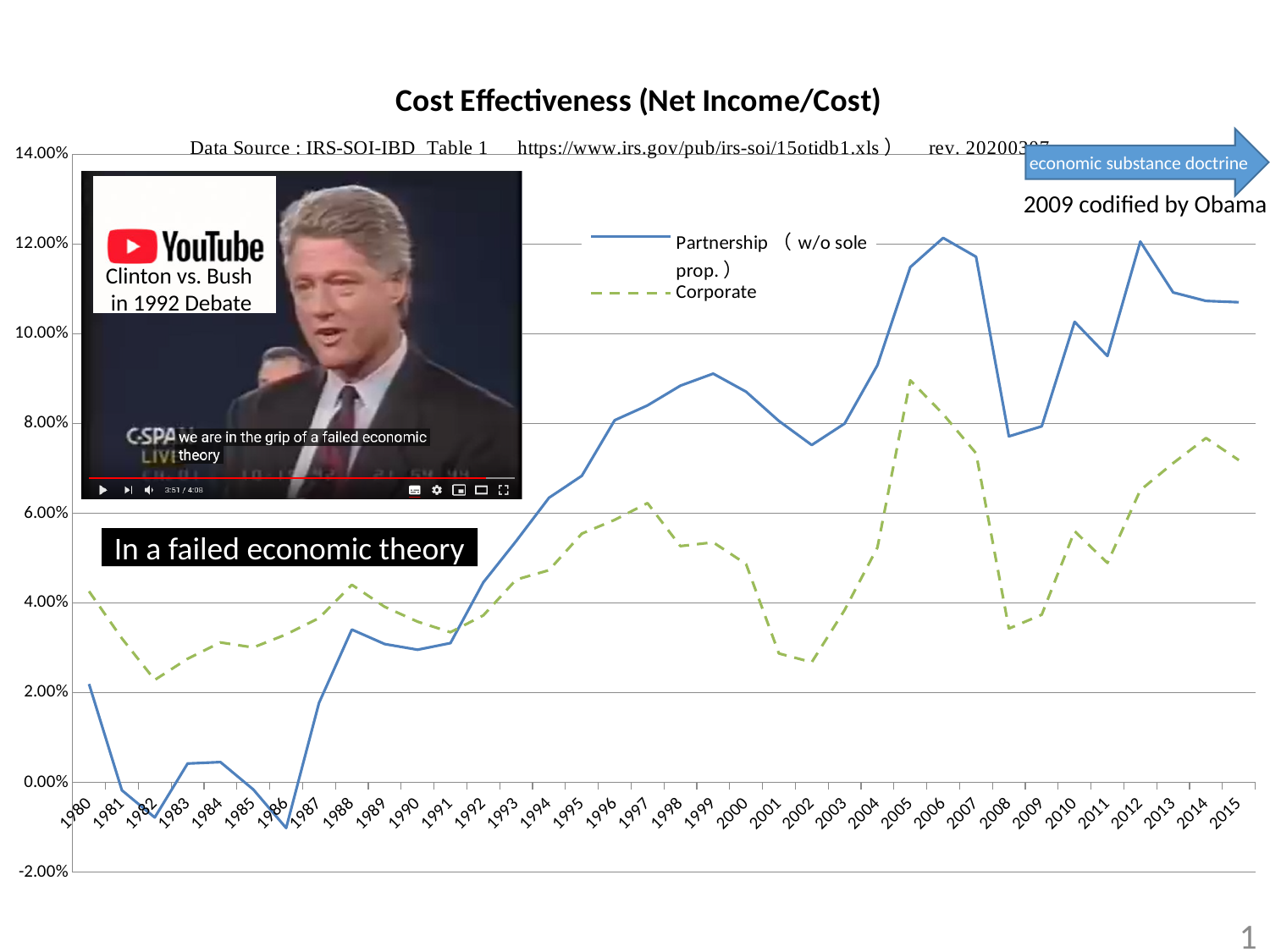
Is the Partnership value for 1986 greater or less than 0.00%? less What kind of chart is shown on the slide? line chart Is the Corporate value for 2001 greater or less than 4.00%? less In 1980, which series has the larger value, Partnership or Corporate? Corporate Is the Partnership value for 2005 greater or less than 10.00%? greater Which series is drawn with a dashed line? Corporate In 2010, which series has the larger value, Partnership or Corporate? Partnership How many years are shown on the x axis? 36 How many series does the legend list? 2 In which year does the Corporate series reach its highest value? 2005 What is the title of the chart? Cost Effectiveness (Net Income/Cost)